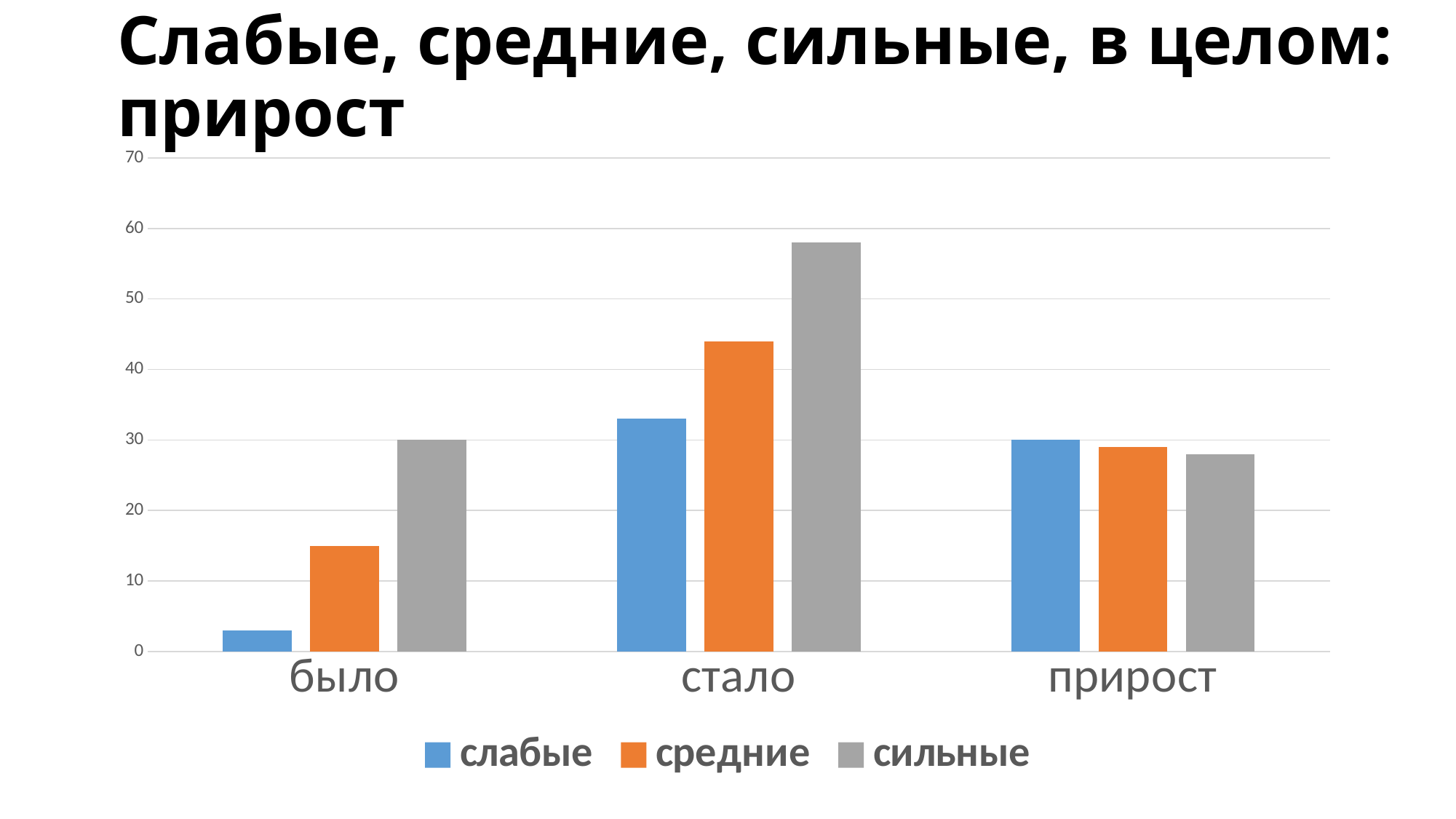
Is the value for слабые in the category было greater or less than 10? less How many series does the legend list? 3 What kind of chart is shown on the slide? bar chart Is the value for средние in the category стало greater or less than 40? greater Which series has the lowest value in the category было? слабые Which is larger: the value for средние in было or the value for средние in стало? стало How many categories are shown along the x axis? 3 Is the value for сильные in the category стало greater or less than 60? less What are the three series names listed in the legend? слабые, средние, сильные What is the value for сильные in the category было? 30 Which series has the highest value in the category стало? сильные What is the value for слабые in the category прирост? 30